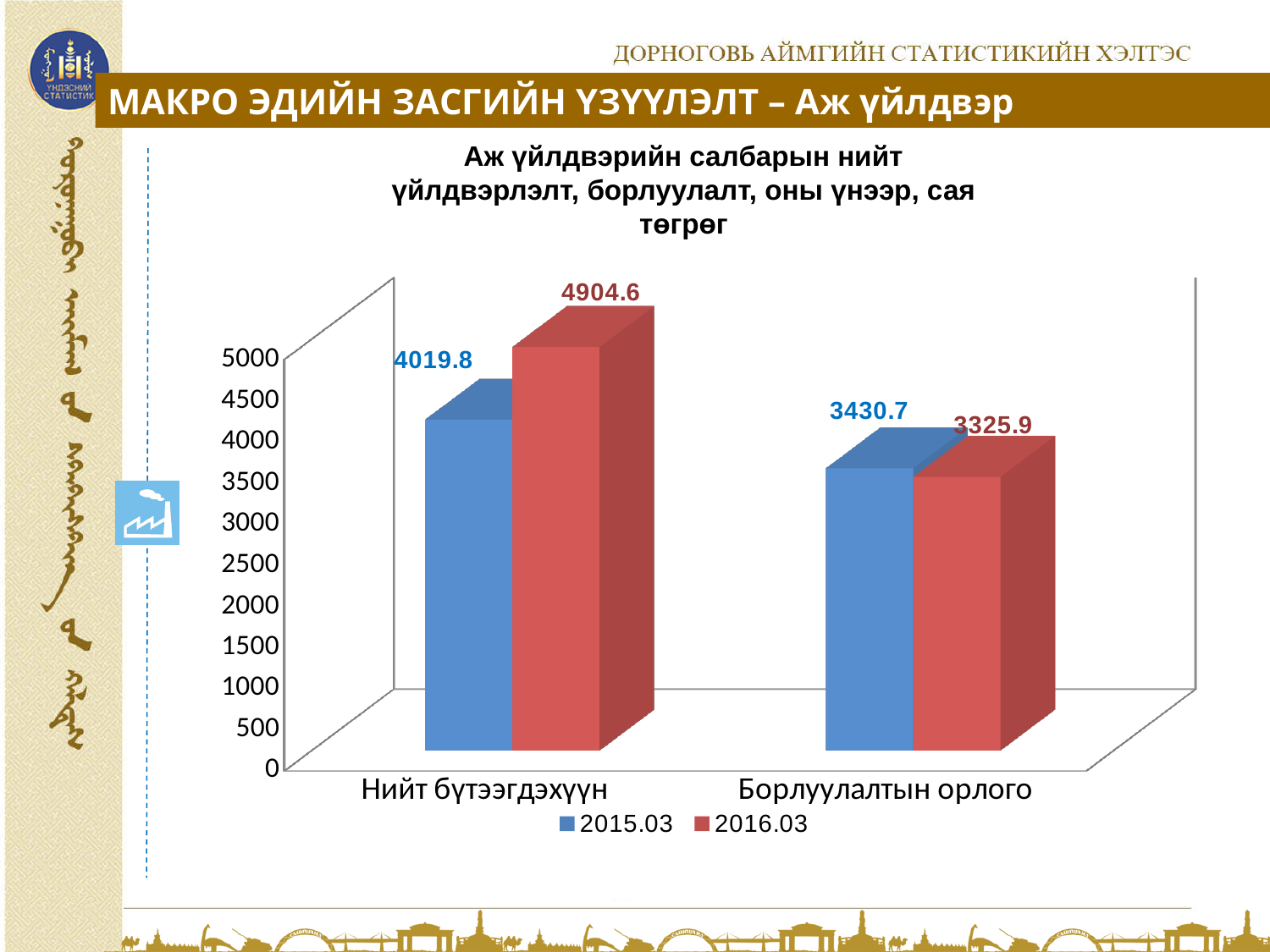
For Борлуулалтын орлого, which series has the larger value, 2015.03 or 2016.03? 2015.03 What is the difference between the 2015.03 and 2016.03 values for Борлуулалтын орлого? 104.8 Which bar has the lowest value on the chart? Борлуулалтын орлого, 2016.03 What is the value for Нийт бүтээгдэхүүн in the 2015.03 series? 4019.8 What is the difference between the 2016.03 and 2015.03 values for Нийт бүтээгдэхүүн? 884.8 What is the value for Борлуулалтын орлого in the 2015.03 series? 3430.7 Which bar has the highest value on the chart? Нийт бүтээгдэхүүн, 2016.03 How many categories are shown on the x axis? 2 What is the value for Нийт бүтээгдэхүүн in the 2016.03 series? 4904.6 What kind of chart is shown on the slide? Bar chart What is the value for Борлуулалтын орлого in the 2016.03 series? 3325.9 How many series does the legend list? 2